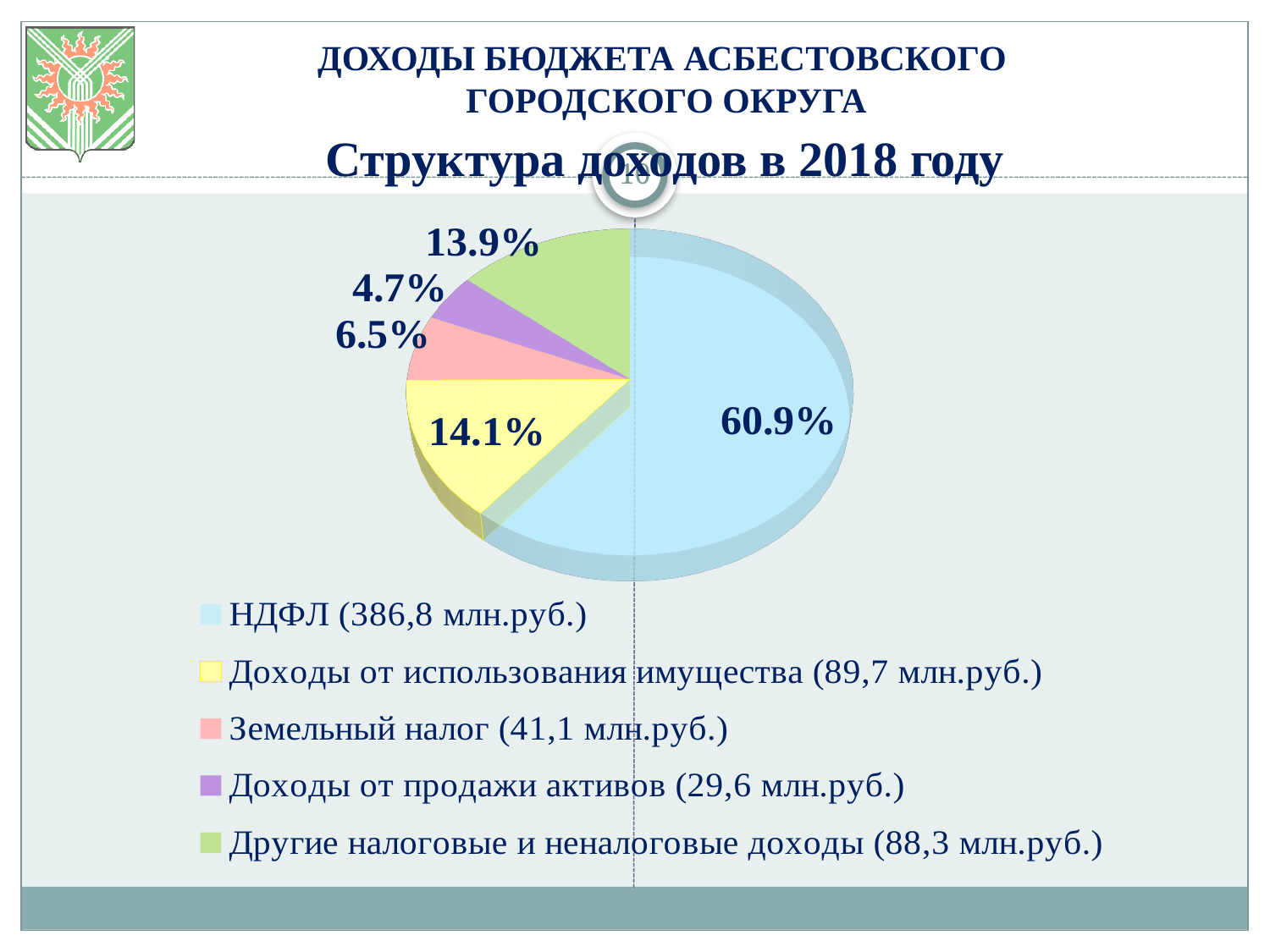
What share of the pie does Доходы от продажи активов account for? 4.7% What share of the pie does Другие налоговые и неналоговые доходы account for? 13.9% What type of chart is shown on the slide? Pie chart How many slices does the pie chart have? 5 What amount in млн.руб. is shown in the legend for Доходы от использования имущества? 89,7 млн.руб. What is the difference in percentage points between the НДФЛ share and the Доходы от использования имущества share? 46.8 percentage points What share of the pie does Земельный налог account for? 6.5% Which category has the largest slice of the pie? НДФЛ What colour is the НДФЛ slice in the pie chart? Light blue Which category has the smallest slice of the pie? Доходы от продажи активов Which is larger: the share for Земельный налог or the share for Доходы от продажи активов? Земельный налог